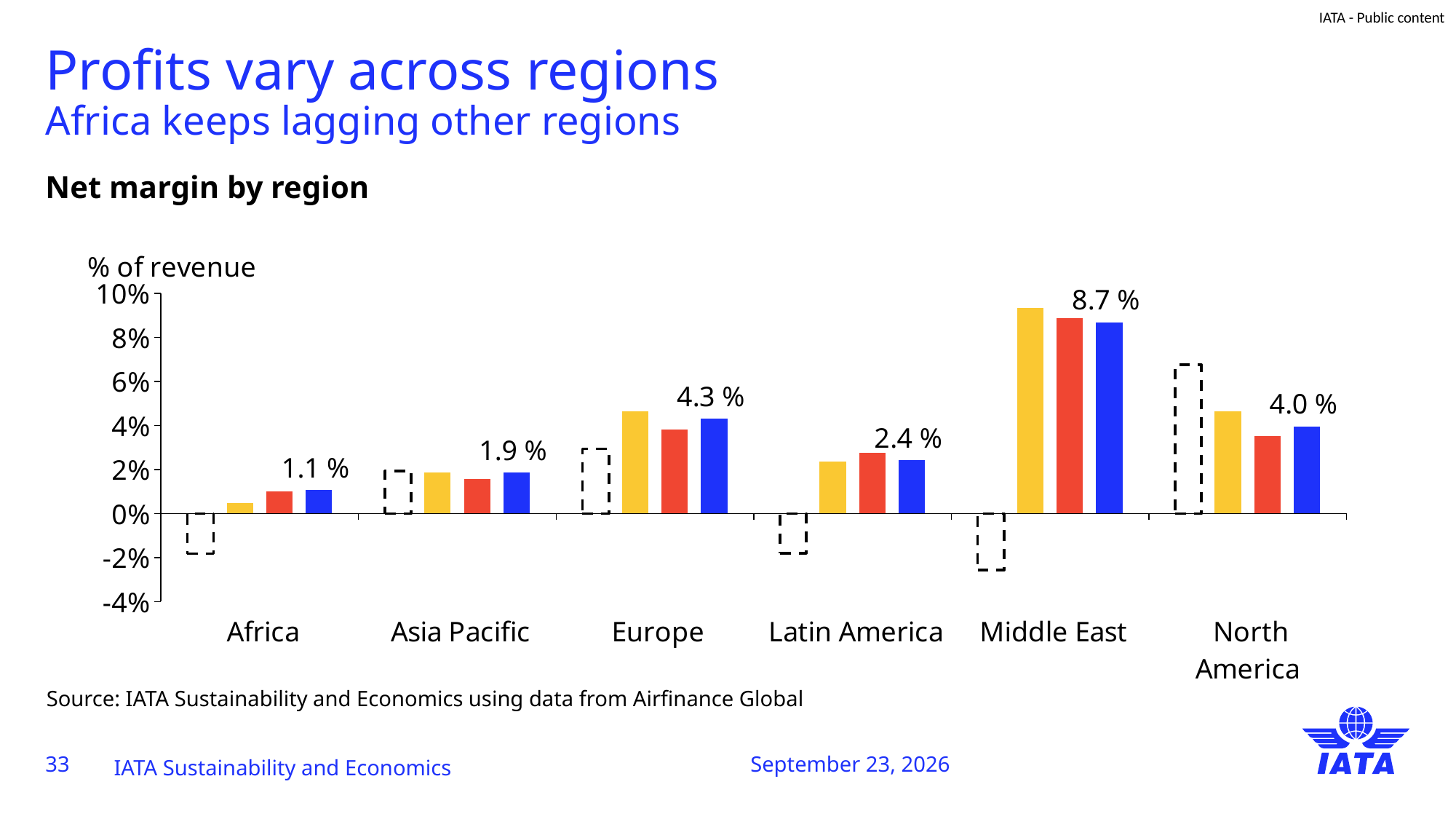
Is the value of the yellow bar for the Middle East greater or less than 8%? greater Which has the larger labelled net margin, Europe or Asia Pacific? Europe What is the labelled net margin for Africa? 1.1 % Which region has the highest labelled net margin? Middle East How many regions are shown on the x axis? 6 Which region has the lowest labelled net margin? Africa What is the labelled net margin for Europe? 4.3 % What is the labelled net margin for Latin America? 2.4 % Is the value of the dashed bar for Africa greater or less than 0%? less What is the difference between the labelled net margins of the Middle East and North America? 4.7 % What is the labelled net margin for the Middle East? 8.7 % What kind of chart is shown on the slide? Bar chart